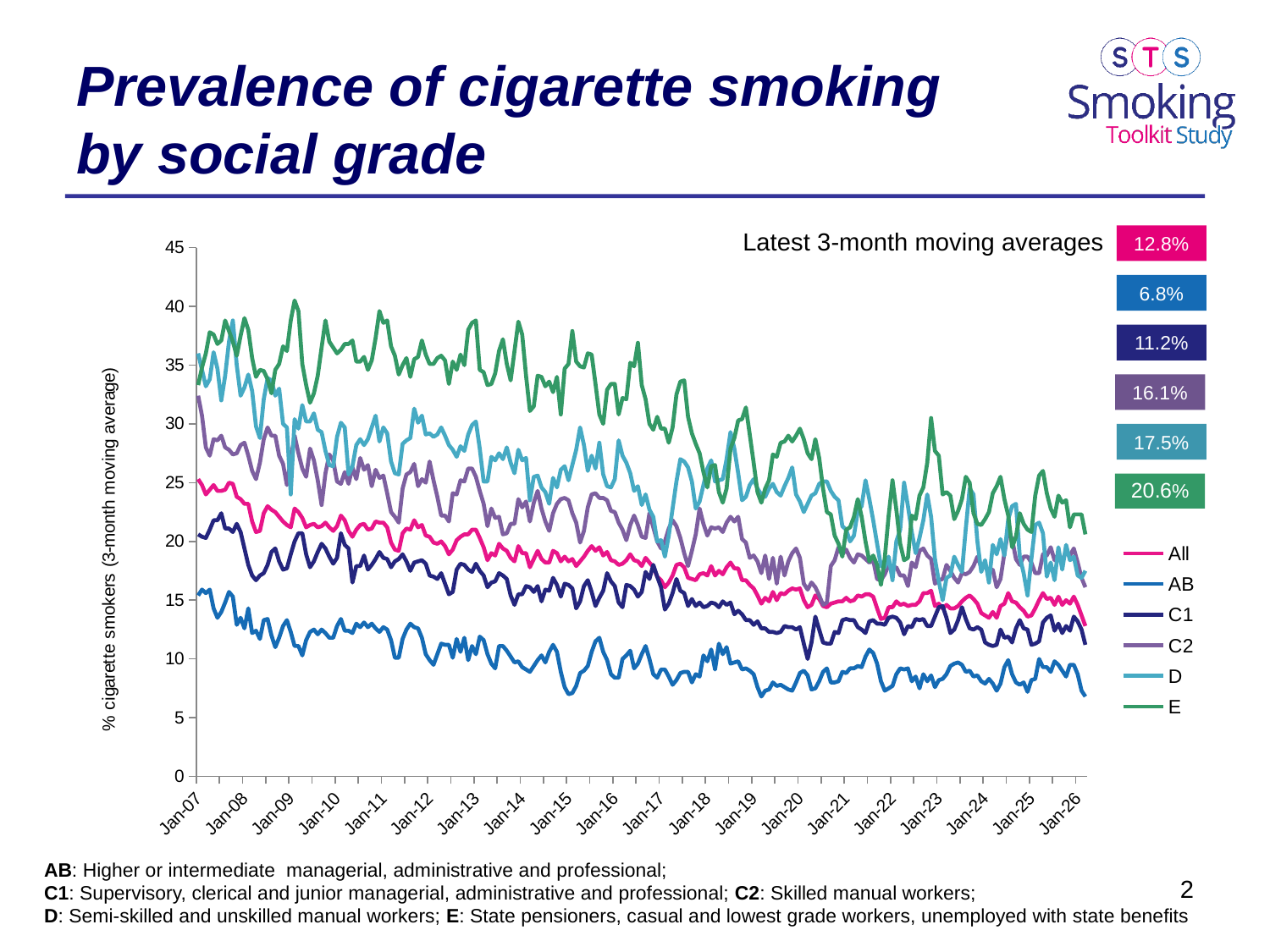
What is the difference between the latest 3-month moving averages for D and C1? 6.3% Which social grade has the lowest latest 3-month moving average? AB Is the value for the E series at Jan-07 greater or less than 30? greater What kind of chart is shown on the slide? line chart How many series does the legend list? 6 Does the All series generally rise or fall from Jan-07 to Jan-26? fall What is the latest 3-month moving average for the C2 social grade? 16.1% Which has a higher latest 3-month moving average, C2 or D? D What is the latest 3-month moving average for the E social grade? 20.6% What is the latest 3-month moving average for the AB social grade? 6.8% What is the latest 3-month moving average for All smokers? 12.8% Which social grade has the highest latest 3-month moving average? E